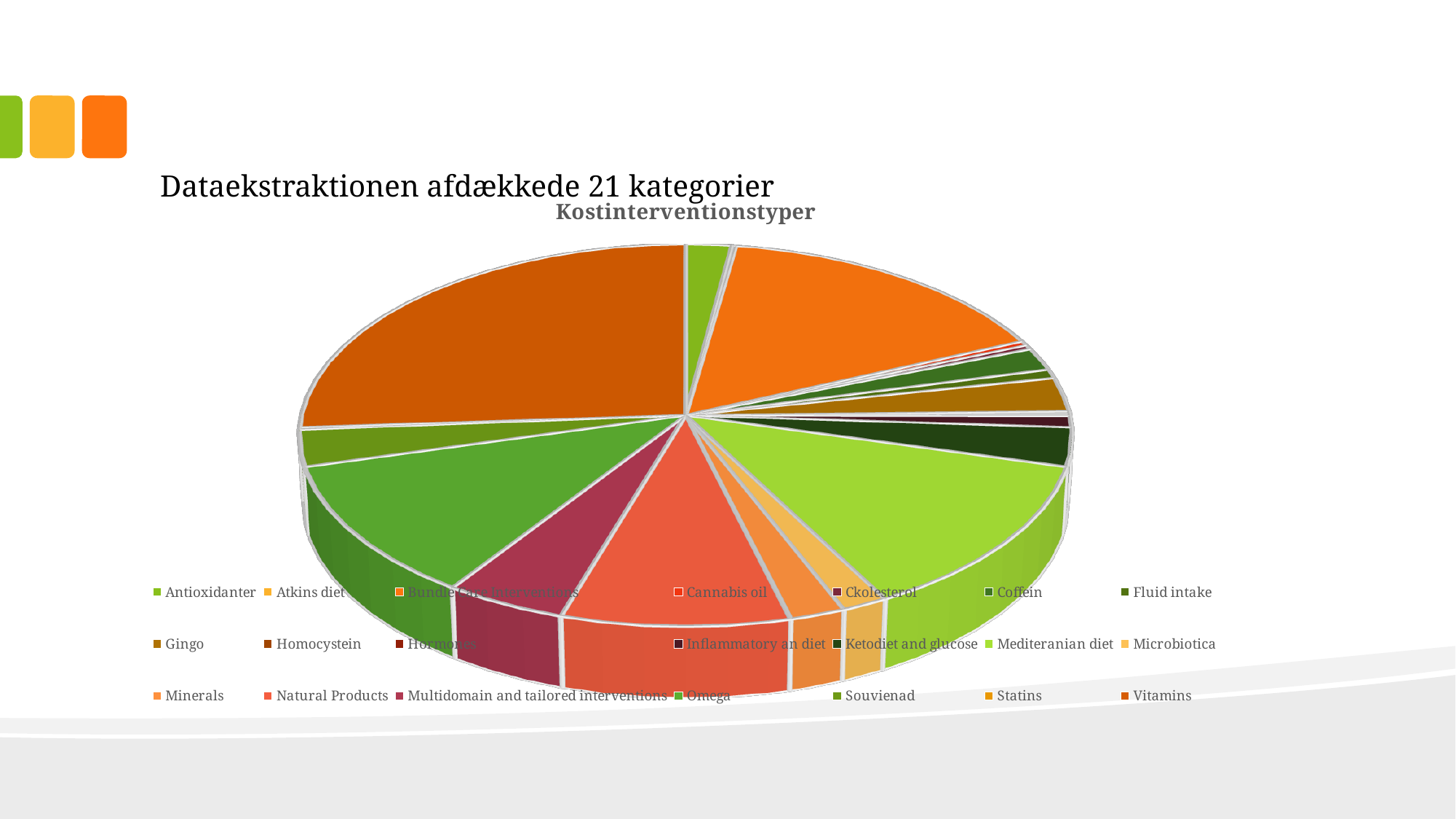
How many categories does the pie chart's legend list? 21 Which slice is larger, Omega or Antioxidanter? Omega Which slice is larger, Bundle Care Interventions or Cannabis oil? Bundle Care Interventions According to the slide heading, how many categories did the data extraction uncover? 21 What is the title of the chart? Kostinterventionstyper Which slice is larger, Natural Products or Minerals? Natural Products Which category has the largest slice of the pie? Vitamins What kind of chart is shown on the slide? Pie chart